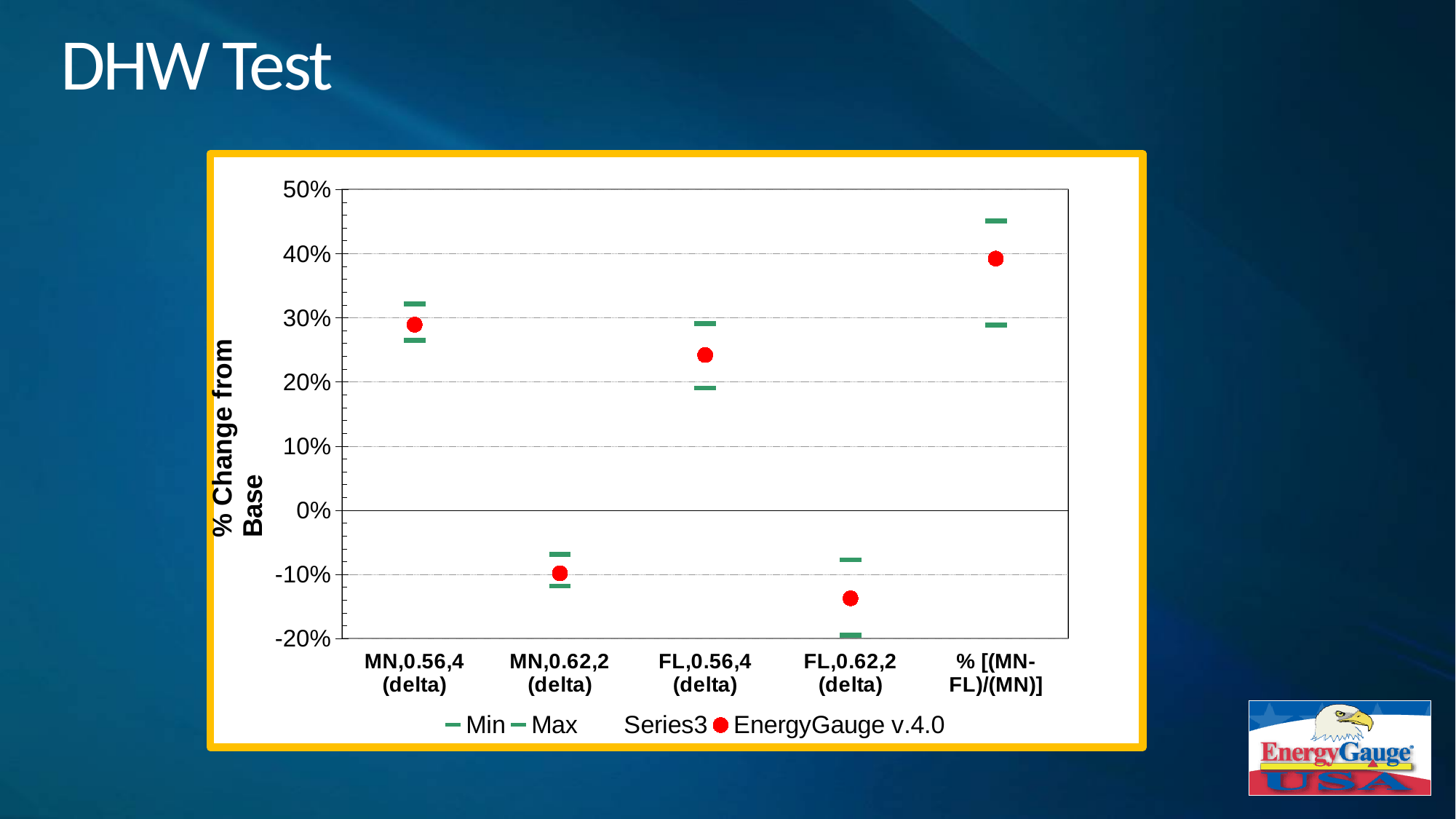
Is the EnergyGauge v.4.0 value for MN,0.62,2 (delta) greater or less than 0%? less Is the EnergyGauge v.4.0 value for % [(MN-FL)/(MN)] greater or less than 30%? greater Which has the larger EnergyGauge v.4.0 value, MN,0.56,4 (delta) or FL,0.56,4 (delta)? MN,0.56,4 (delta) How many categories are shown on the x axis of the chart? 5 Is the EnergyGauge v.4.0 value for MN,0.56,4 (delta) greater or less than 20%? greater What is the title of the vertical axis? % Change from Base What kind of chart is shown on the slide? Scatter (dot) chart Which category has the lowest EnergyGauge v.4.0 value? FL,0.62,2 (delta) How many series does the chart legend list? 4 What colour are the EnergyGauge v.4.0 markers in the chart? Red Which category has the highest EnergyGauge v.4.0 value? % [(MN-FL)/(MN)]